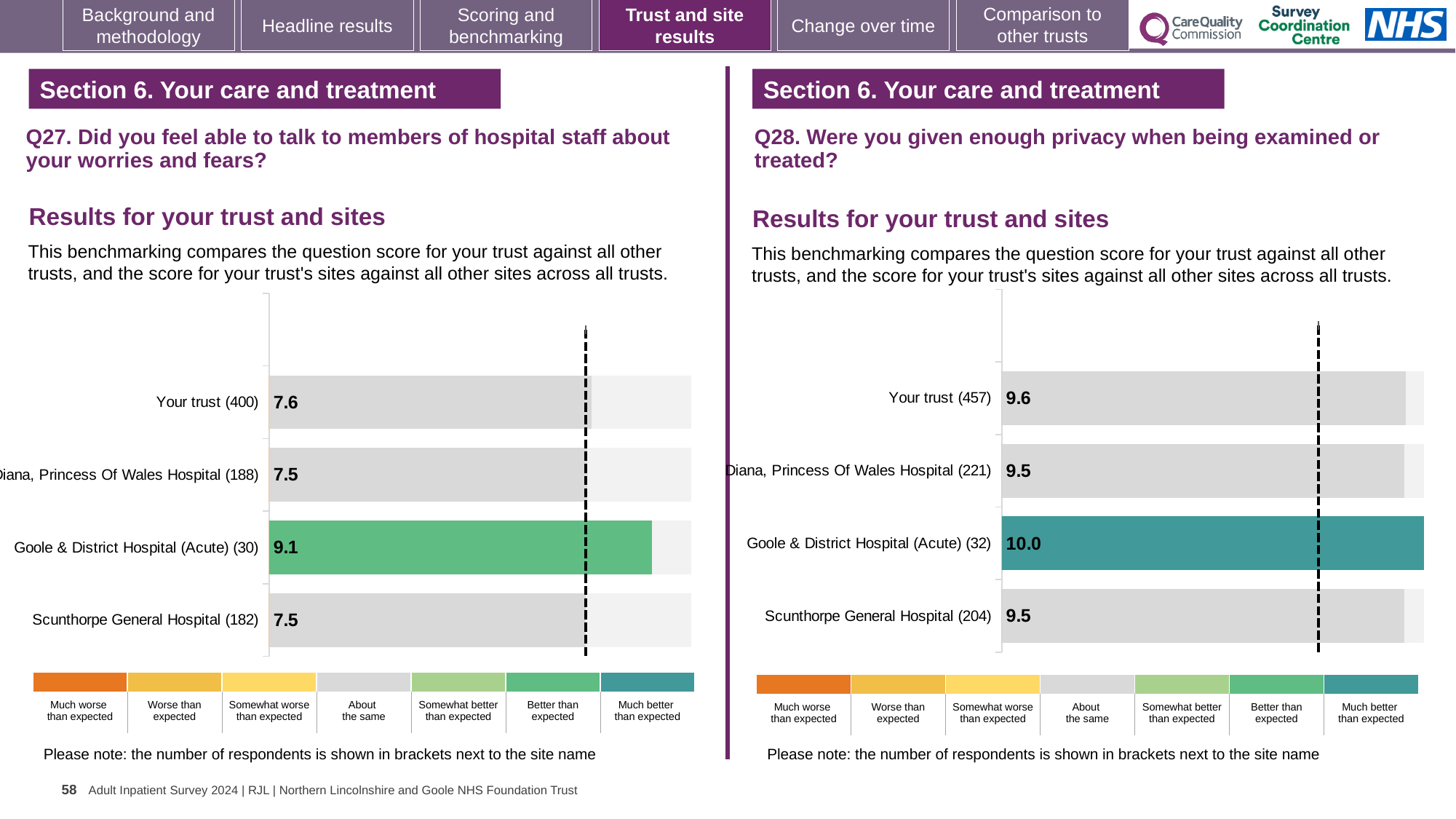
On the Q28 chart (right), what is the score for Scunthorpe General Hospital (204)? 9.5 On the Q28 chart (right), what is the score for Your trust (457)? 9.6 On the Q27 chart (left), how many bars are plotted? 4 On the Q28 chart (right), which site has the highest score? Goole & District Hospital (Acute) (32) On the Q27 chart (left), what is the score for Your trust (400)? 7.6 Which is larger: the Q27 score for Your trust or the Q28 score for Your trust? Q28 score for Your trust On the Q28 chart (right), what colour is the bar for Goole & District Hospital (Acute) (32)? Teal (Much better than expected) On the Q27 chart (left), what is the score for Goole & District Hospital (Acute) (30)? 9.1 On the Q27 chart (left), which site has the highest score? Goole & District Hospital (Acute) (30) What type of chart is used on the Q28 chart (right)? Bar chart On the Q27 chart (left), what is the difference between the scores for Goole & District Hospital (Acute) and Scunthorpe General Hospital? 1.6 On the Q28 chart (right), what is the difference between the scores for Goole & District Hospital (Acute) and Your trust? 0.4